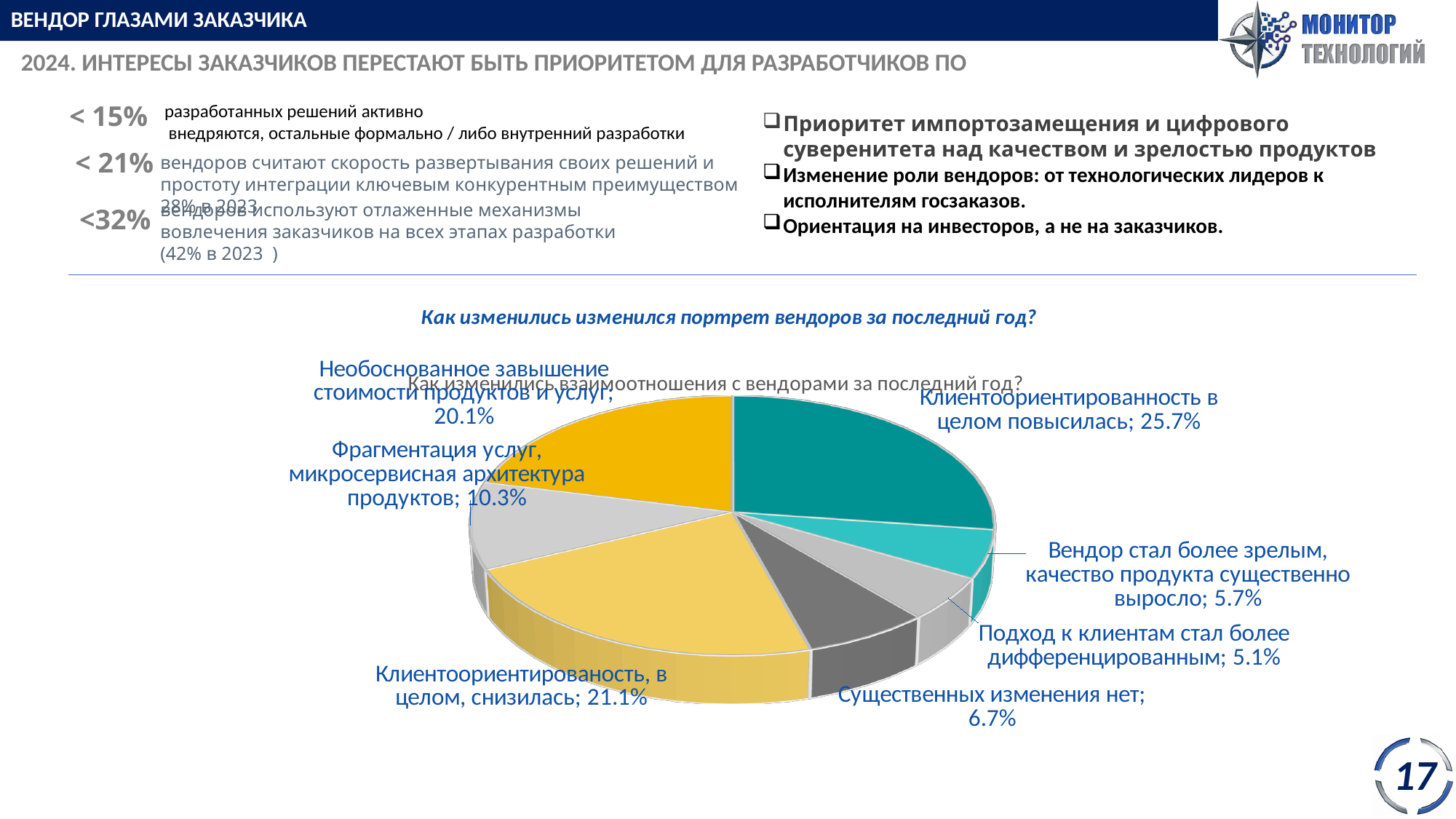
Какое значение указано для категории «Существенных изменения нет»? 6.7% На сколько процентных пунктов доля «Клиентоориентированность в целом повысилась» больше доли «Клиентоориентированость, в целом, снизилась»? 4.6 Что больше: доля «Необоснованное завышение стоимости продуктов и услуг» или доля «Фрагментация услуг, микросервисная архитектура продуктов»? Необоснованное завышение стоимости продуктов и услуг Какова сумма долей категорий «Существенных изменения нет» и «Подход к клиентам стал более дифференцированным»? 11.8% Какое значение указано для категории «Фрагментация услуг, микросервисная архитектура продуктов»? 10.3% Какая доля приходится на категорию «Клиентоориентированность в целом повысилась»? 25.7% Сколько категорий (секторов) показано на круговой диаграмме? 7 Какой тип диаграммы показан на слайде? Круговая диаграмма Какая категория имеет наибольшую долю на диаграмме? Клиентоориентированность в целом повысилась Какое значение указано для категории «Вендор стал более зрелым, качество продукта существенно выросло»? 5.7% Какая категория имеет наименьшую долю на диаграмме? Подход к клиентам стал более дифференцированным